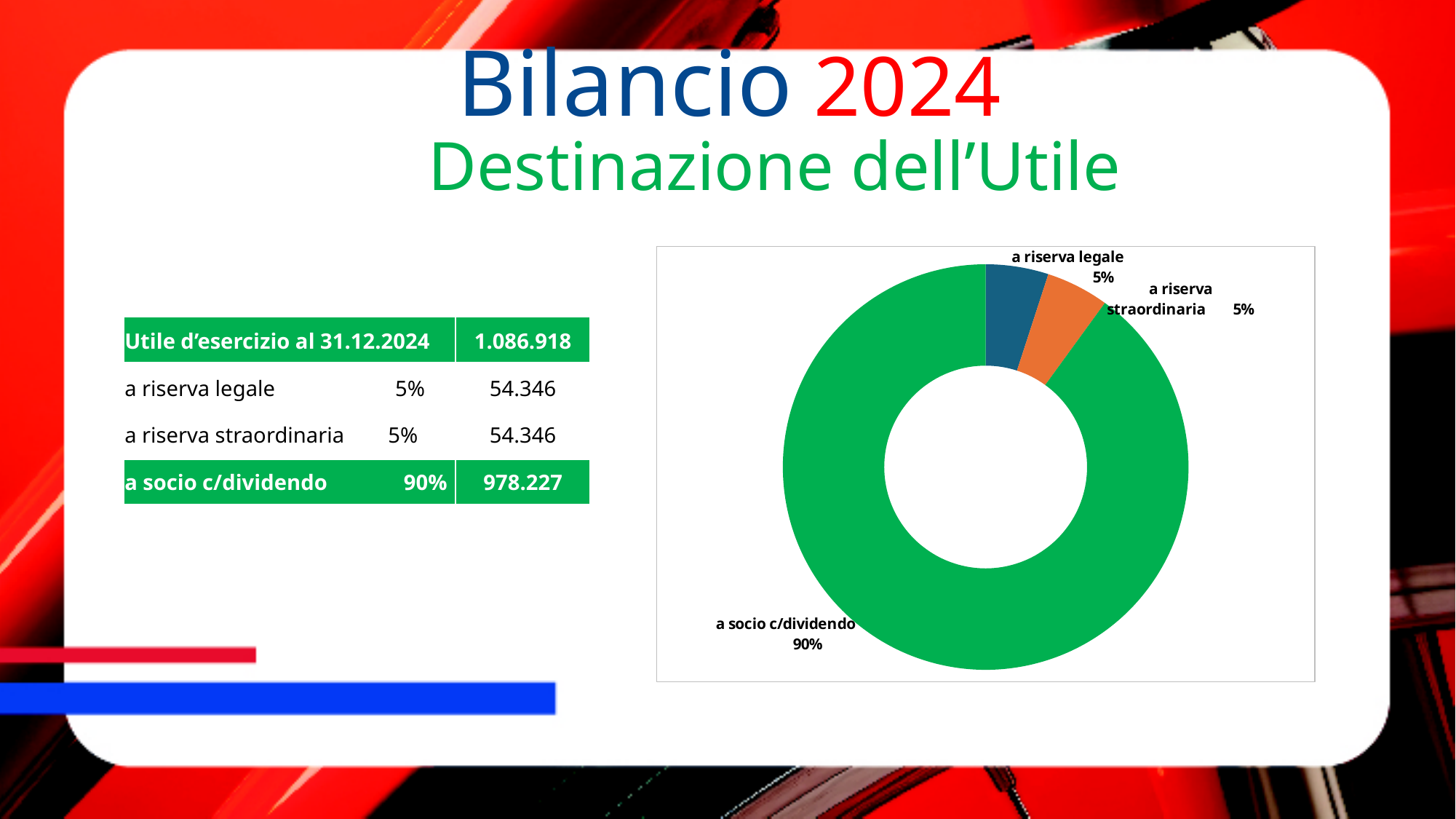
What is the difference in percentage points between the 'a socio c/dividendo' slice and the 'a riserva legale' slice? 85 percentage points What colour is the 'a socio c/dividendo' slice in the doughnut chart? Green What share of the doughnut chart does 'a riserva legale' represent? 5% What kind of chart is shown on the slide? Doughnut (pie) chart Is the share for 'a socio c/dividendo' greater or less than 50%? greater What colour is the 'a riserva straordinaria' slice in the doughnut chart? Orange What share of the doughnut chart does 'a socio c/dividendo' represent? 90% Which is larger in the doughnut chart: 'a socio c/dividendo' or 'a riserva legale'? a socio c/dividendo How many slices does the doughnut chart have? 3 Which category has the largest slice in the doughnut chart? a socio c/dividendo What share of the doughnut chart does 'a riserva straordinaria' represent? 5%